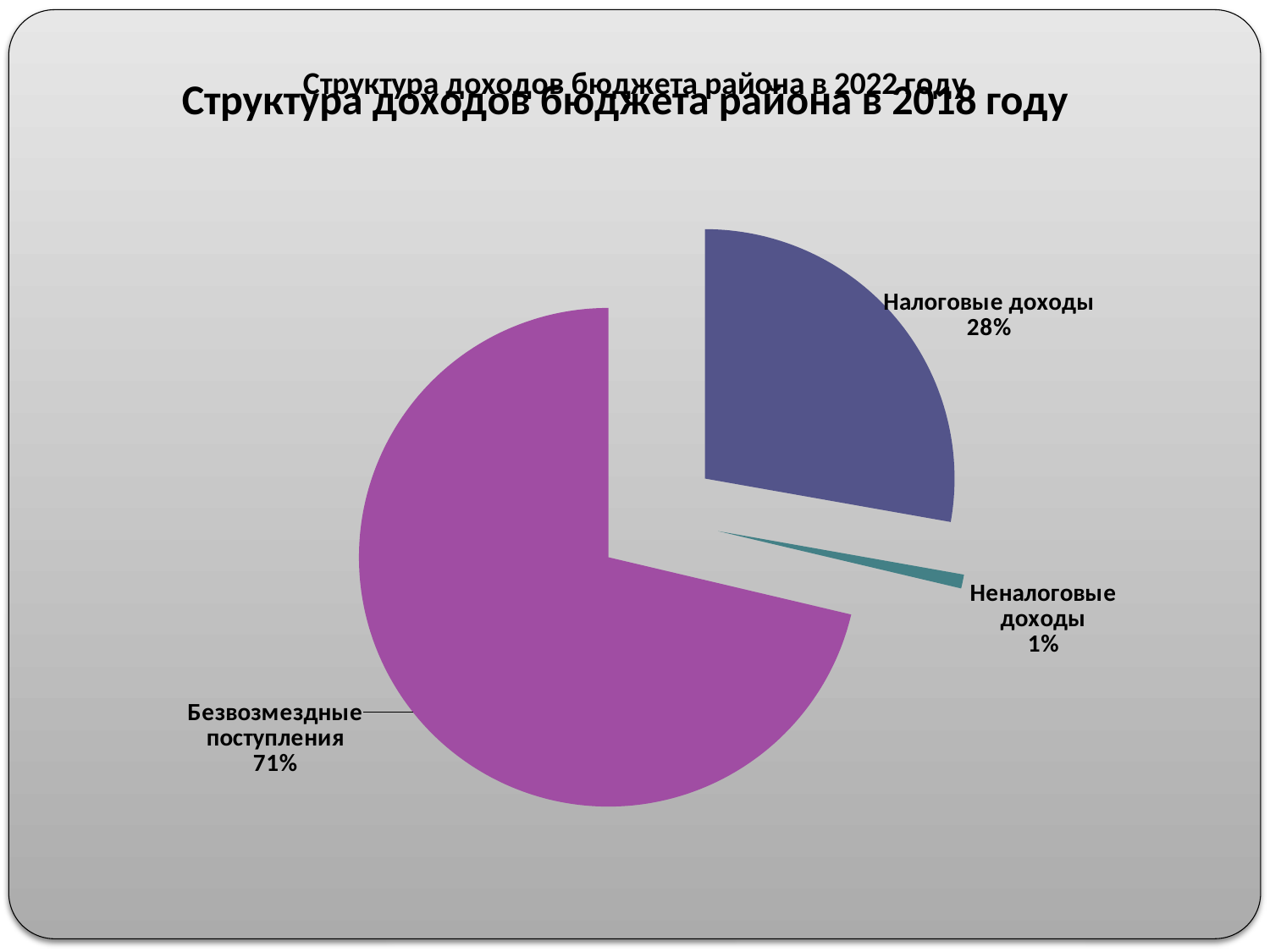
What kind of chart is shown on the slide? Pie chart Which is larger, Налоговые доходы or Неналоговые доходы? Налоговые доходы What share of the pie does Неналоговые доходы have? 1% Which category has the smallest slice of the pie? Неналоговые доходы Which category has the largest slice of the pie? Безвозмездные поступления What is the difference in percentage points between Безвозмездные поступления and Налоговые доходы? 43 What share of the pie does Безвозмездные поступления have? 71% What colour is the slice for Безвозмездные поступления? Purple (magenta) What is the difference in percentage points between Налоговые доходы and Неналоговые доходы? 27 How many slices does the pie chart have? 3 Which is larger, Безвозмездные поступления or Налоговые доходы? Безвозмездные поступления What share of the pie does Налоговые доходы have? 28%